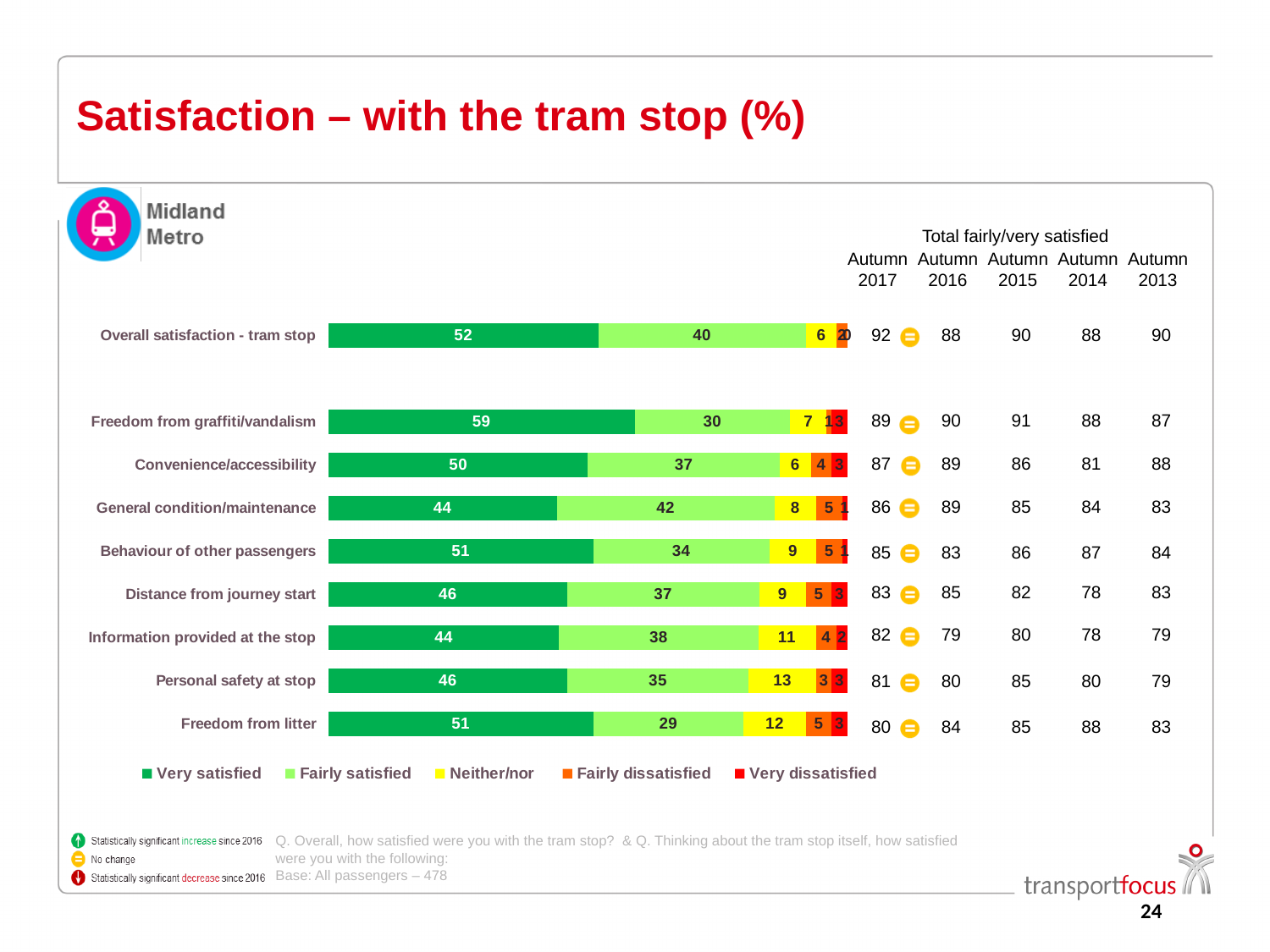
What is the combined Very satisfied and Fairly satisfied value for Freedom from litter? 80 What is the Very satisfied value for Freedom from graffiti/vandalism? 59 What is the Fairly satisfied value for General condition/maintenance? 42 Which category has the lowest Fairly satisfied value? Freedom from litter How many categories are plotted in the chart? 9 What colour represents Neither/nor in the legend? Yellow What is the difference between the Very satisfied values for Freedom from graffiti/vandalism and General condition/maintenance? 15 What is the Neither/nor value for Personal safety at stop? 13 How many series does the legend list? 5 Which has the larger Fairly satisfied value: Convenience/accessibility or Information provided at the stop? Information provided at the stop What kind of chart is shown on the slide? Stacked bar chart Which category has the highest Very satisfied value? Freedom from graffiti/vandalism